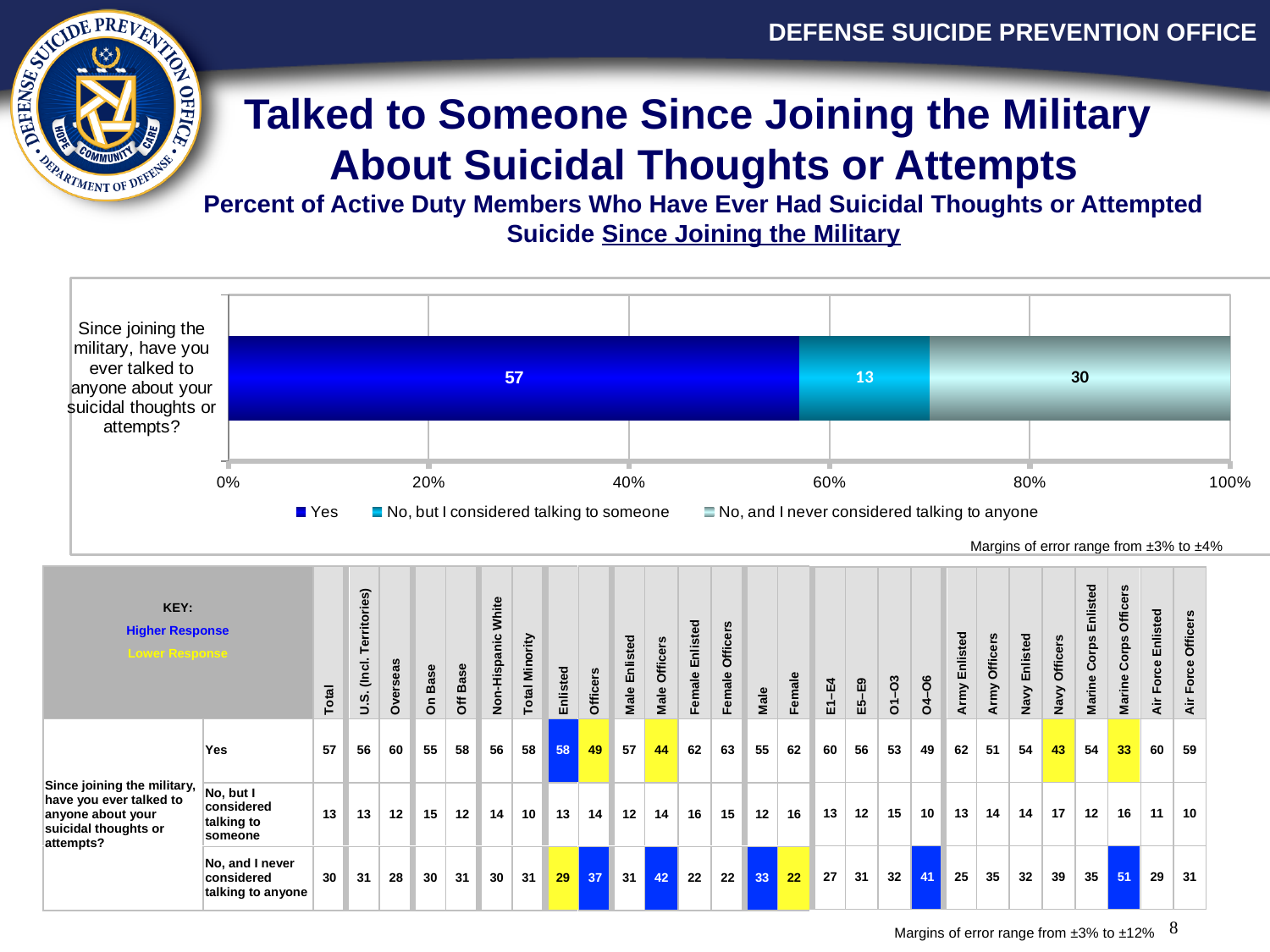
Which response category has the largest segment in the bar chart? Yes What is the difference between the "Yes" segment and the "No, and I never considered talking to anyone" segment? 27 What is the value of the "No, and I never considered talking to anyone" segment in the bar chart? 30 What is the total of the three segments in the stacked bar? 100 What kind of chart is shown on the slide? Stacked bar chart Which is larger in the bar chart: the "No, but I considered talking to someone" segment or the "No, and I never considered talking to anyone" segment? No, and I never considered talking to anyone What is the value of the "Yes" segment in the bar chart? 57 What is the value of the "No, but I considered talking to someone" segment in the bar chart? 13 How many series does the chart legend list? 3 Which response category has the smallest segment in the bar chart? No, but I considered talking to someone What question is the bar chart labelled with on its left side? Since joining the military, have you ever talked to anyone about your suicidal thoughts or attempts? What is the maximum value shown on the horizontal axis of the chart? 100%